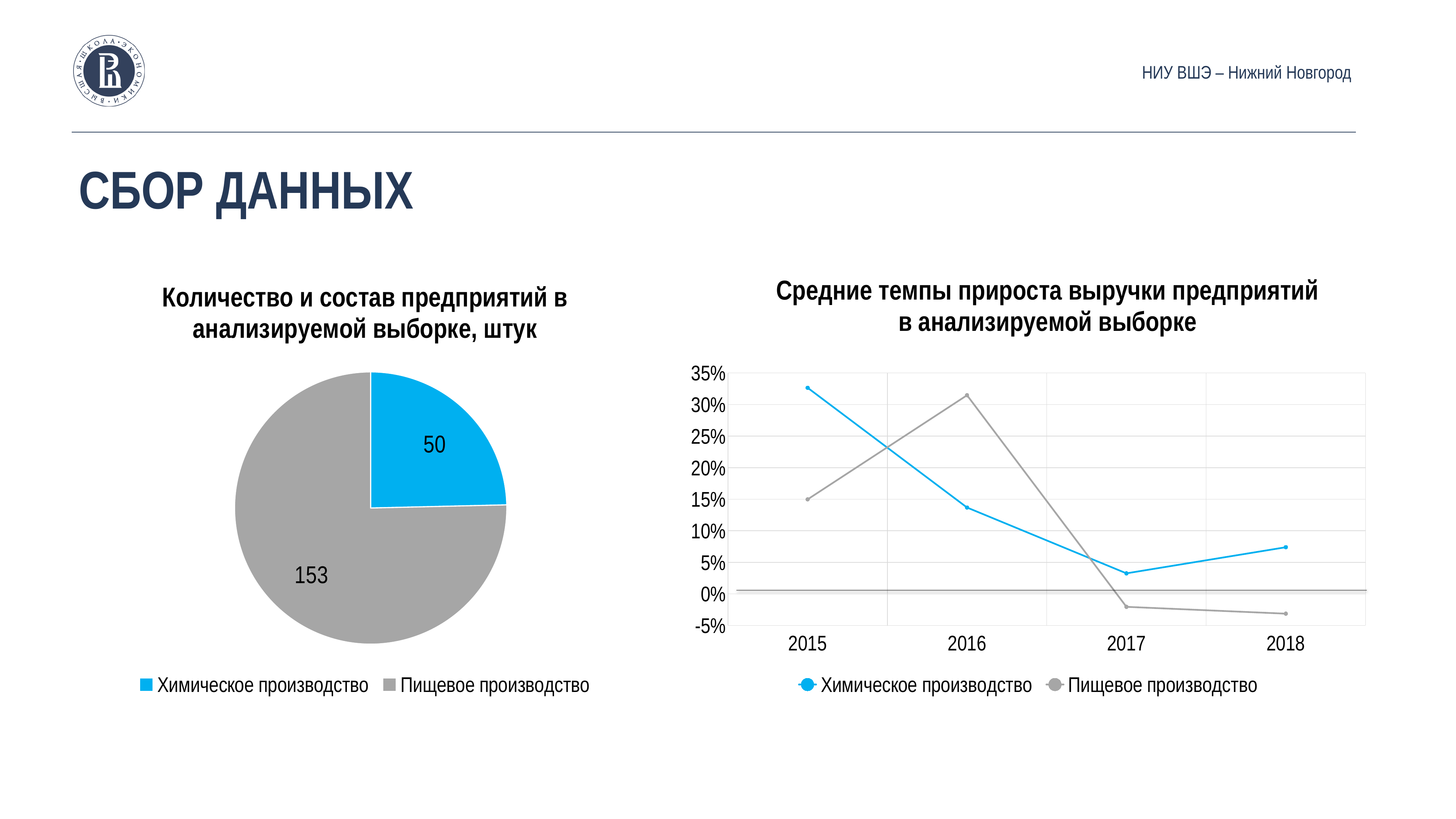
In the right line chart, how many years are shown on the x axis? 4 In the right line chart, is the value for Пищевое производство in 2017 greater or less than 0%? less In the right line chart, how many series does the legend list? 2 In the pie chart on the left, what is the value for Пищевое производство? 153 In the right line chart, is the value for Химическое производство in 2015 greater or less than 30%? greater What type of chart is the right chart titled 'Средние темпы прироста выручки предприятий в анализируемой выборке'? line chart In the pie chart on the left, which category has the larger slice? Пищевое производство In the pie chart on the left, what is the difference between Пищевое производство and Химическое производство? 103 What type of chart is the left chart titled 'Количество и состав предприятий в анализируемой выборке, штук'? pie chart In the right line chart, which series has the higher value in 2016? Пищевое производство In the pie chart on the left, what is the value for Химическое производство? 50 In the pie chart on the left, what is the total of the two slices? 203